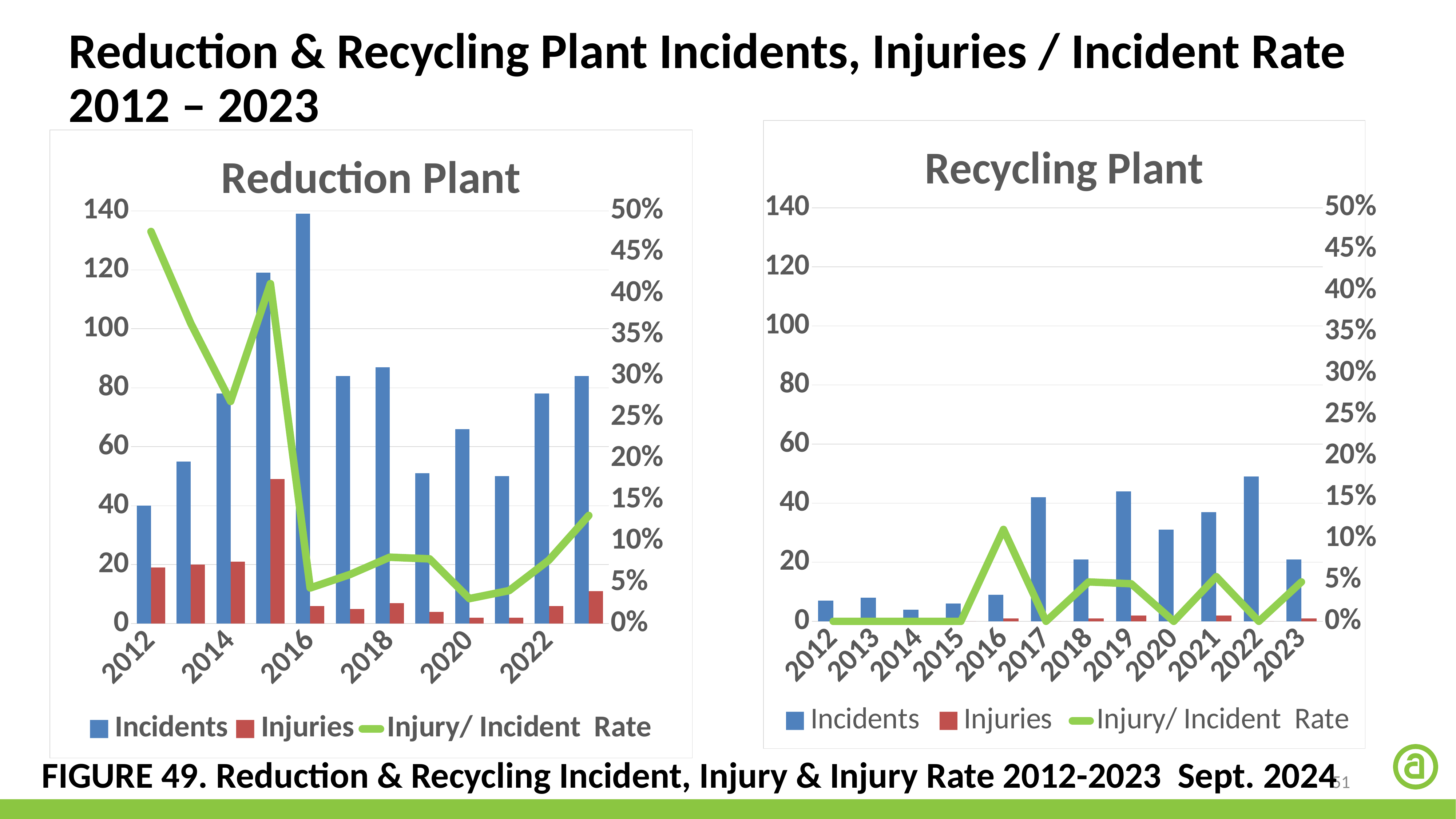
On the Recycling Plant chart, which year has the lowest number of Incidents? 2014 On the Reduction Plant chart, is the Injury/Incident Rate for 2012 greater or less than 40%? greater On the Recycling Plant chart, is the Incidents value for 2017 greater or less than 20? greater On the Reduction Plant chart, which year has the highest number of Incidents? 2016 On the Reduction Plant chart, which is larger, the Incidents value for 2015 or for 2019? 2015 How many series does the legend of the Recycling Plant chart list? 3 On the Reduction Plant chart, which year has the highest number of Injuries? 2015 On the Recycling Plant chart, which year has the highest number of Incidents? 2022 How many years are shown on the x axis of the Recycling Plant chart? 12 On the Reduction Plant chart, is the Incidents value for 2016 greater or less than 120? greater